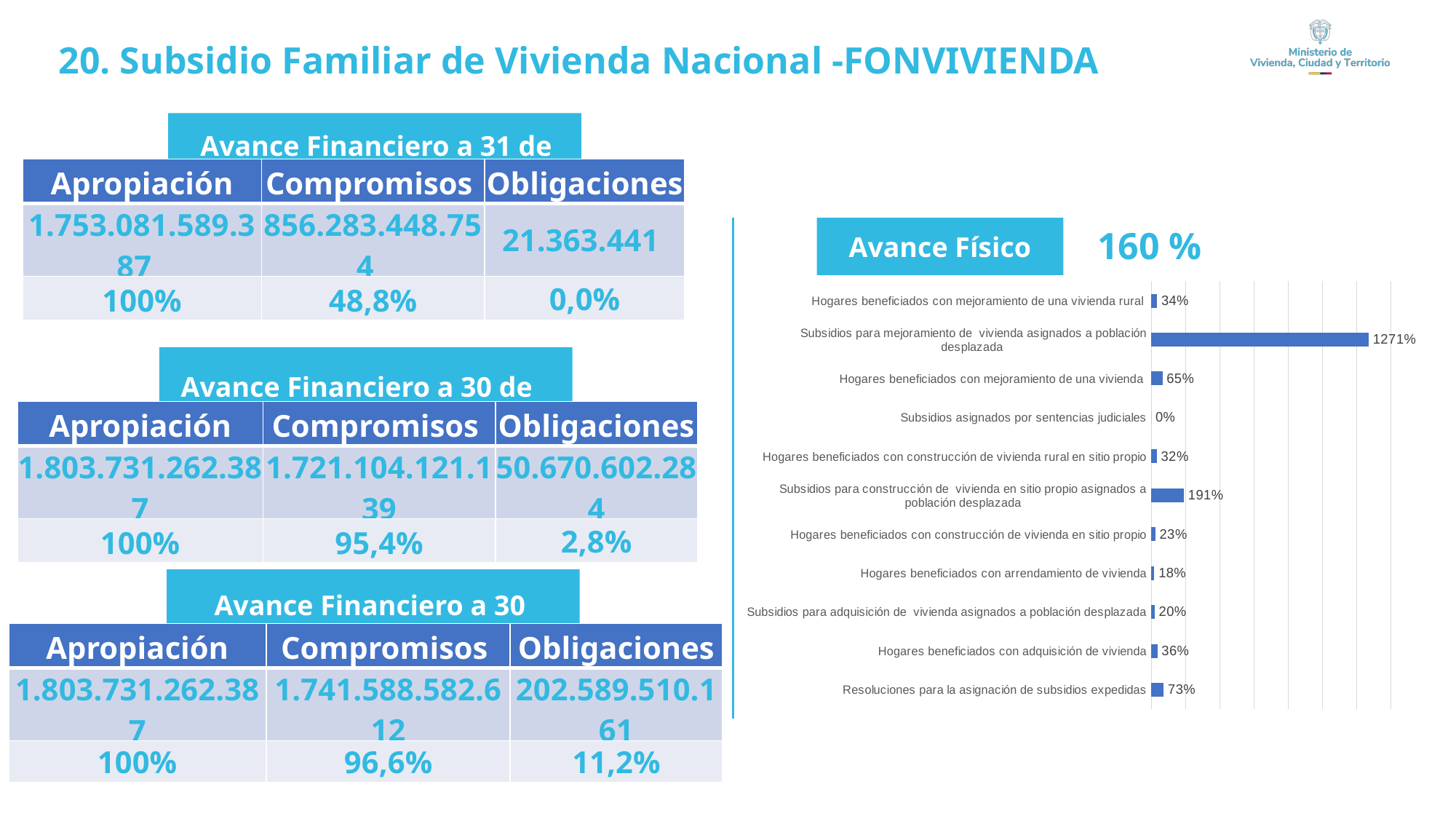
What overall percentage is printed next to the 'Avance Físico' heading above the chart? 160 % In the 'Avance Físico' chart, what is the value for 'Subsidios para construcción de vivienda en sitio propio asignados a población desplazada'? 191% In the 'Avance Físico' chart, which is larger: 'Hogares beneficiados con mejoramiento de una vivienda rural' or 'Hogares beneficiados con construcción de vivienda en sitio propio'? Hogares beneficiados con mejoramiento de una vivienda rural How many categories does the 'Avance Físico' bar chart show? 11 In the 'Avance Físico' chart, what is the value for 'Hogares beneficiados con arrendamiento de vivienda'? 18% Which category has the lowest value in the 'Avance Físico' chart? Subsidios asignados por sentencias judiciales Which category has the highest value in the 'Avance Físico' chart? Subsidios para mejoramiento de vivienda asignados a población desplazada What kind of chart is shown under the 'Avance Físico' heading? bar chart In the 'Avance Físico' chart, what is the value for 'Hogares beneficiados con mejoramiento de una vivienda'? 65% In the 'Avance Físico' chart, what is the value for 'Resoluciones para la asignación de subsidios expedidas'? 73% In the 'Avance Físico' chart, what is the value for 'Subsidios para adquisición de vivienda asignados a población desplazada'? 20% In the 'Avance Físico' chart, what is the difference between 'Resoluciones para la asignación de subsidios expedidas' and 'Hogares beneficiados con adquisición de vivienda'? 37 percentage points